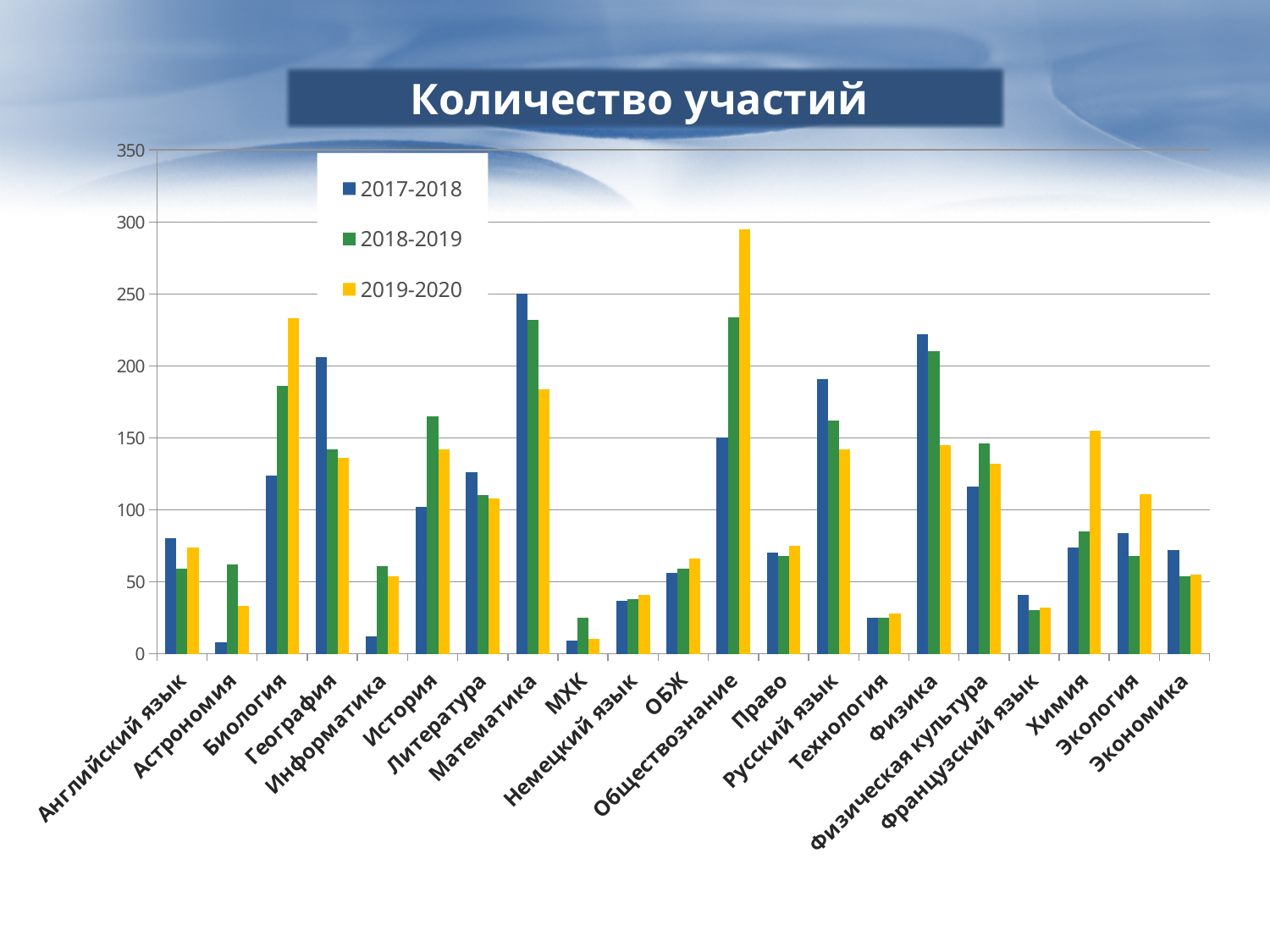
For Биология, which series has the larger value: 2017-2018 or 2019-2020? 2019-2020 Is the 2017-2018 value for Технология greater or less than 50? less Do the values for Математика rise or fall from 2017-2018 to 2019-2020? fall Which subject has the lowest value for the 2019-2020 series? МХК Which subject has the highest value for the 2019-2020 series? Обществознание What kind of chart is shown on the slide? bar chart How many series does the legend list? 3 Which subject has the highest value for the 2017-2018 series? Математика Is the 2019-2020 value for Химия greater or less than 100? greater Is the 2019-2020 value for Биология greater or less than 200? greater How many subject categories are shown on the x axis? 21 What is the title of the chart? Количество участий